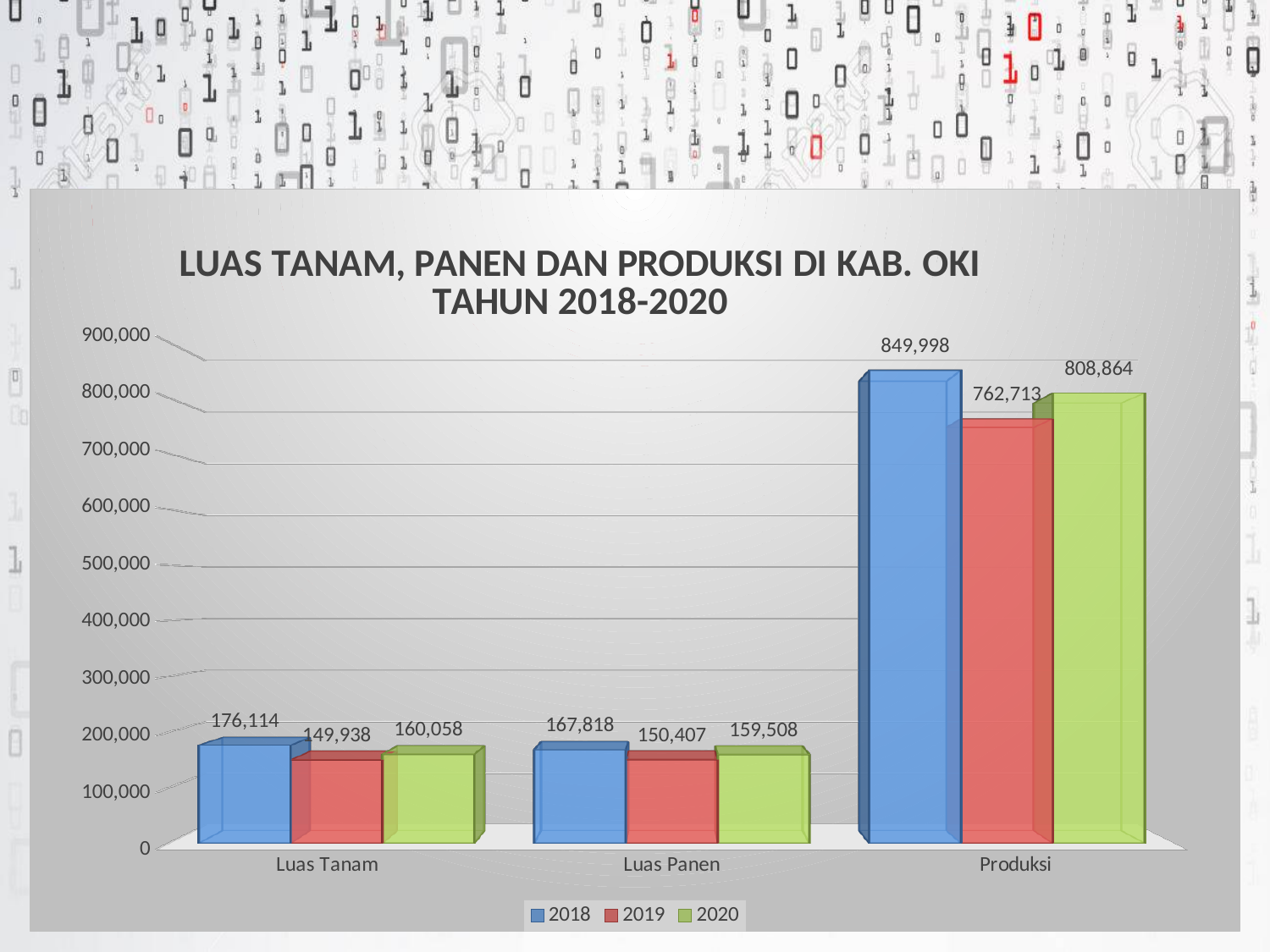
How many series does the legend list? 3 What is the difference between the Produksi values for 2018 and 2019? 87,285 Which year has the highest value for Produksi? 2018 Which year has the lowest value for Luas Tanam? 2019 What is the value for Produksi in 2020? 808,864 Which is larger, Luas Panen in 2020 or Luas Panen in 2019? Luas Panen in 2020 Is the value for Produksi in 2019 greater or less than 700,000? greater What is the value for Luas Panen in 2019? 150,407 What kind of chart is shown on the slide? Bar chart What is the value for Luas Tanam in 2018? 176,114 How many categories are shown on the x axis? 3 What is the title of the chart? LUAS TANAM, PANEN DAN PRODUKSI DI KAB. OKI TAHUN 2018-2020